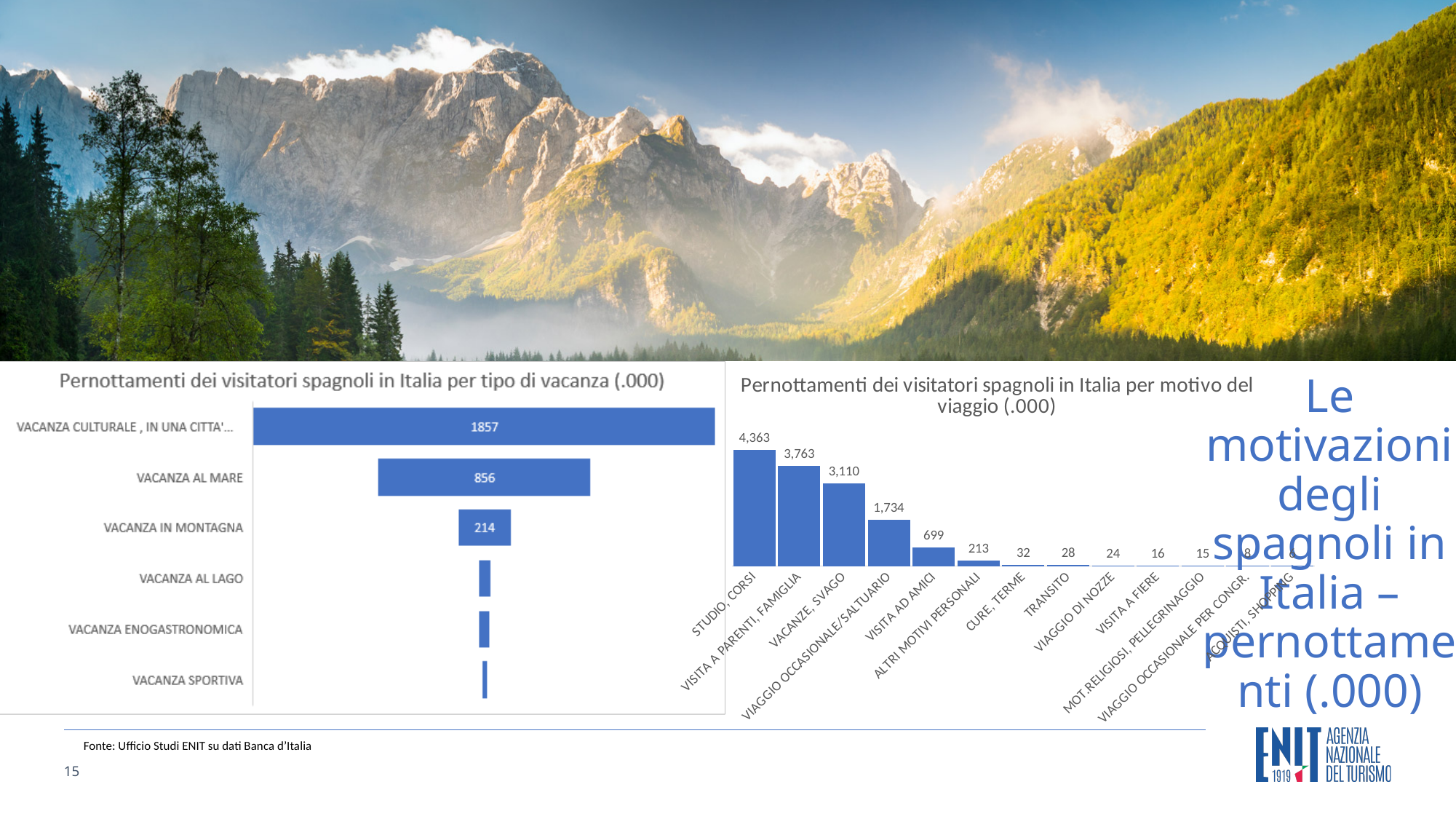
In the chart 'Pernottamenti dei visitatori spagnoli in Italia per tipo di vacanza (.000)', what is the difference between VACANZA CULTURALE, IN UNA CITTA'... and VACANZA AL MARE? 1001 In the chart 'Pernottamenti dei visitatori spagnoli in Italia per motivo del viaggio (.000)', which category has the highest value? STUDIO, CORSI In the chart 'Pernottamenti dei visitatori spagnoli in Italia per tipo di vacanza (.000)', what is the value for VACANZA AL MARE? 856 How many categories are shown in the chart 'Pernottamenti dei visitatori spagnoli in Italia per tipo di vacanza (.000)'? 6 In the chart 'Pernottamenti dei visitatori spagnoli in Italia per motivo del viaggio (.000)', do the values rise or fall from left to right along the x axis? Fall In the chart 'Pernottamenti dei visitatori spagnoli in Italia per motivo del viaggio (.000)', what is the value for VIAGGIO OCCASIONALE/SALTUARIO? 1,734 In the chart 'Pernottamenti dei visitatori spagnoli in Italia per tipo di vacanza (.000)', which category has the highest value? VACANZA CULTURALE, IN UNA CITTA'... In the chart 'Pernottamenti dei visitatori spagnoli in Italia per motivo del viaggio (.000)', which is larger: VISITA AD AMICI or ALTRI MOTIVI PERSONALI? VISITA AD AMICI In the chart 'Pernottamenti dei visitatori spagnoli in Italia per motivo del viaggio (.000)', what is the difference between VISITA A PARENTI, FAMIGLIA and VACANZE, SVAGO? 653 In the chart 'Pernottamenti dei visitatori spagnoli in Italia per motivo del viaggio (.000)', what is the value for STUDIO, CORSI? 4,363 What kind of chart is 'Pernottamenti dei visitatori spagnoli in Italia per tipo di vacanza (.000)'? Bar chart In the chart 'Pernottamenti dei visitatori spagnoli in Italia per tipo di vacanza (.000)', what is the value for VACANZA IN MONTAGNA? 214